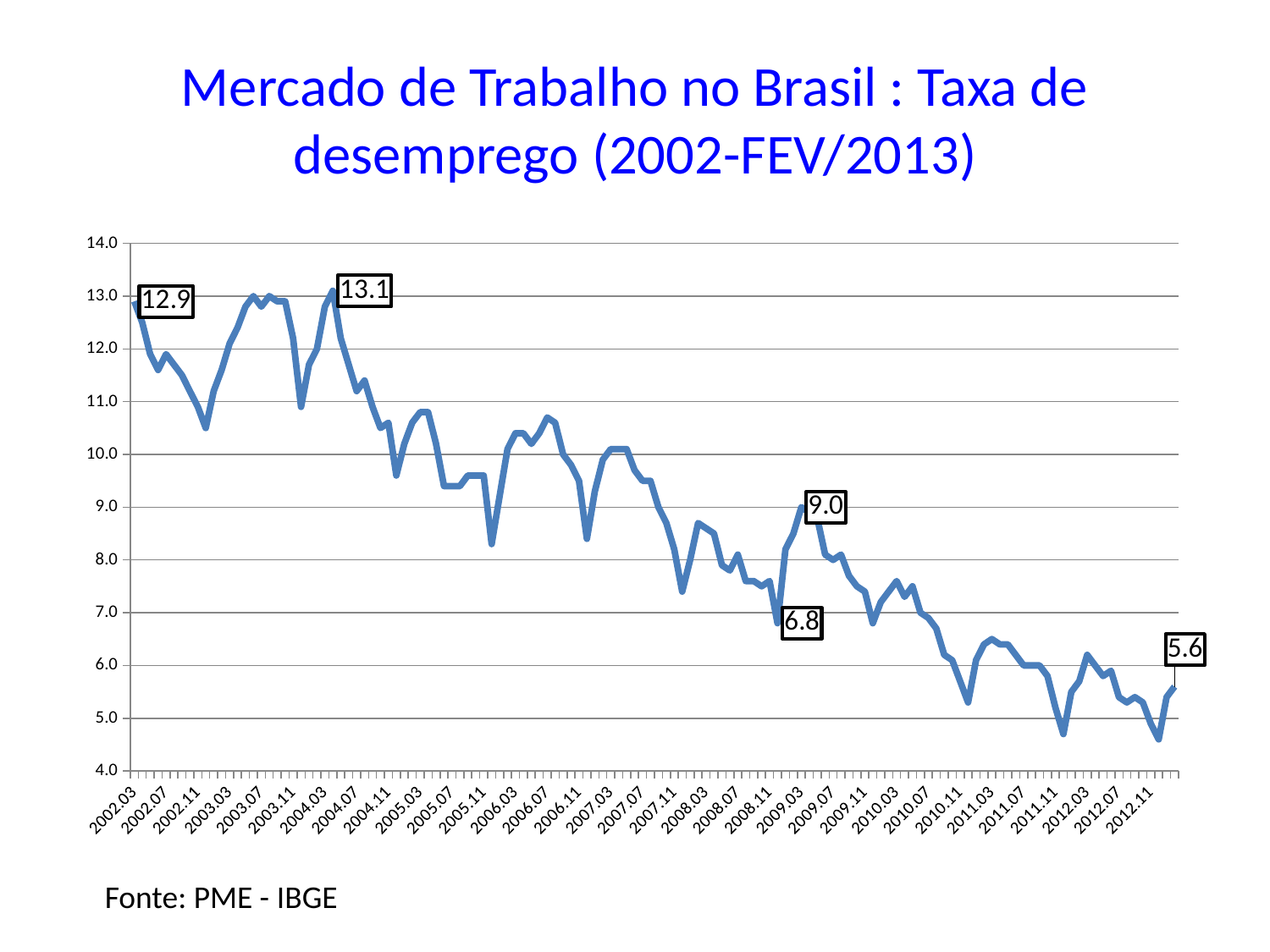
What is the unemployment rate at the first point of the series (2002.03)? 12.9 What kind of chart is shown on the slide? line chart What is the difference between the peak labelled value (13.1) and the final labelled value (5.6)? 7.5 What is the difference between the labelled values 9.0 and 6.8? 2.2 Is the value at 2010.11 greater or less than 6.0? less What source is cited below the chart? PME - IBGE Which is larger, the labelled value at the start of the series or the labelled value at the end? the start (12.9) What is the unemployment rate at the last point of the series? 5.6 What is the difference between the first labelled value (12.9) and the last labelled value (5.6)? 7.3 Is the value at 2003.07 greater or less than 12.0? greater Does the unemployment rate generally rise or fall from 2002 to 2013? fall What is the highest labelled value on the chart? 13.1